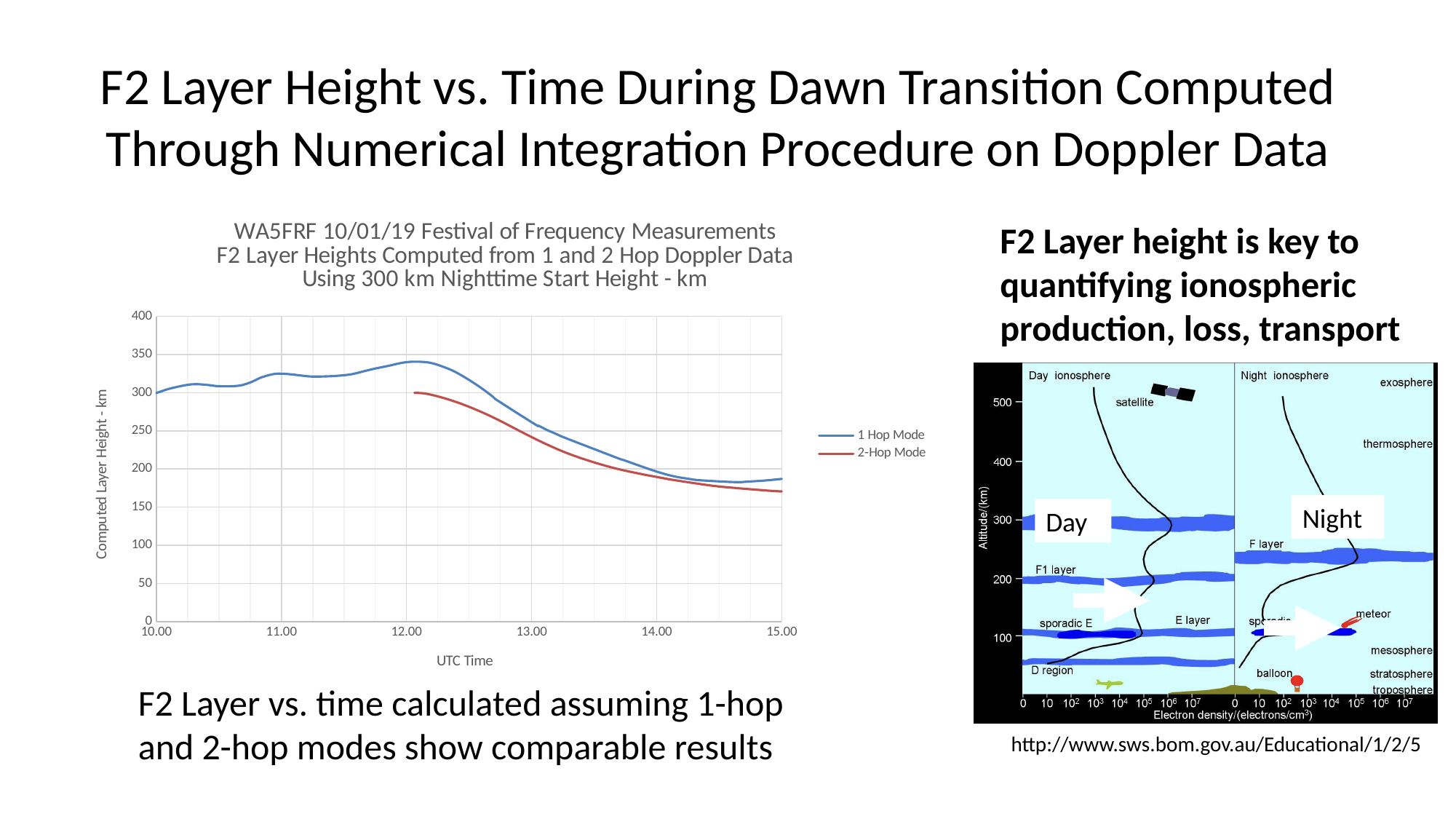
In the left chart, is the 1 Hop Mode value at 15.00 UTC greater or less than 200? less In the left chart, is the 2-Hop Mode value at 12.00 UTC greater or less than 250? greater In the left chart, do the values of the 1 Hop Mode series rise or fall between 10.00 and 12.00 UTC? rise In the left chart, is the 1 Hop Mode value at 10.00 UTC greater or less than 250? greater In the left chart, at 13.00 UTC, which series has the higher value, 1 Hop Mode or 2-Hop Mode? 1 Hop Mode What are the two series named in the legend of the left chart? 1 Hop Mode and 2-Hop Mode How many series does the legend of the left chart list? 2 What is the x-axis label of the left chart? UTC Time What kind of chart is shown on the left of the slide? line chart In the left chart, do the values of the 1 Hop Mode series rise or fall between 12.00 and 15.00 UTC? fall